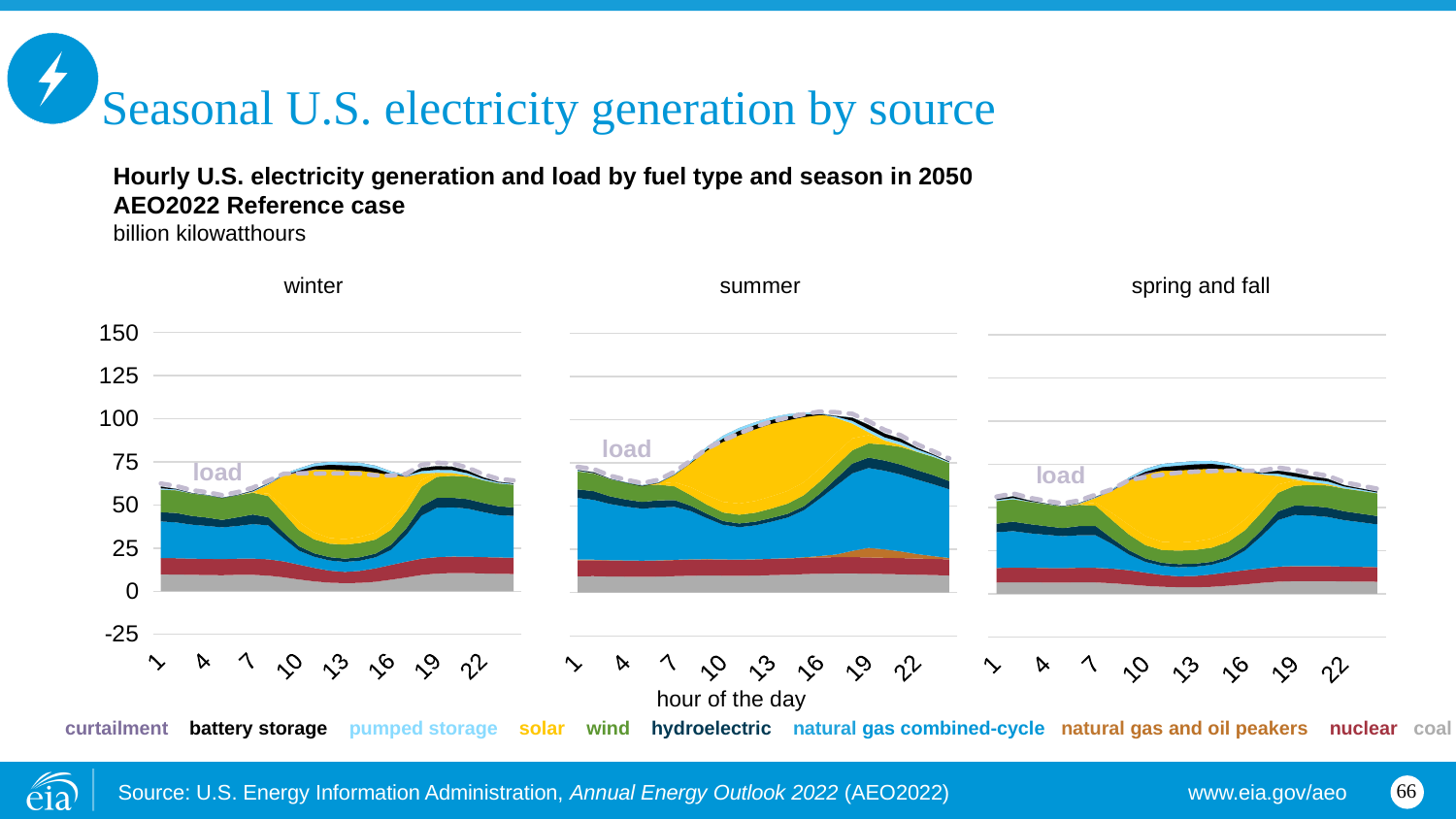
In the summer chart, which source contributes the largest share of generation around midday? solar Which season's chart shows the highest peak total generation? summer How many series does the legend list? 10 How many seasonal panels are shown on the slide? 3 What kind of chart is used for the winter, summer, and spring and fall panels? stacked area chart What unit is the y axis measured in? billion kilowatthours In the winter chart, is the peak total generation greater or less than 100? less In the spring and fall chart, is the peak total generation greater or less than 100? less In the spring and fall chart, is total generation at hour 1 greater or less than 75? less In the summer chart, does total generation rise or fall from hour 7 to hour 13? rise